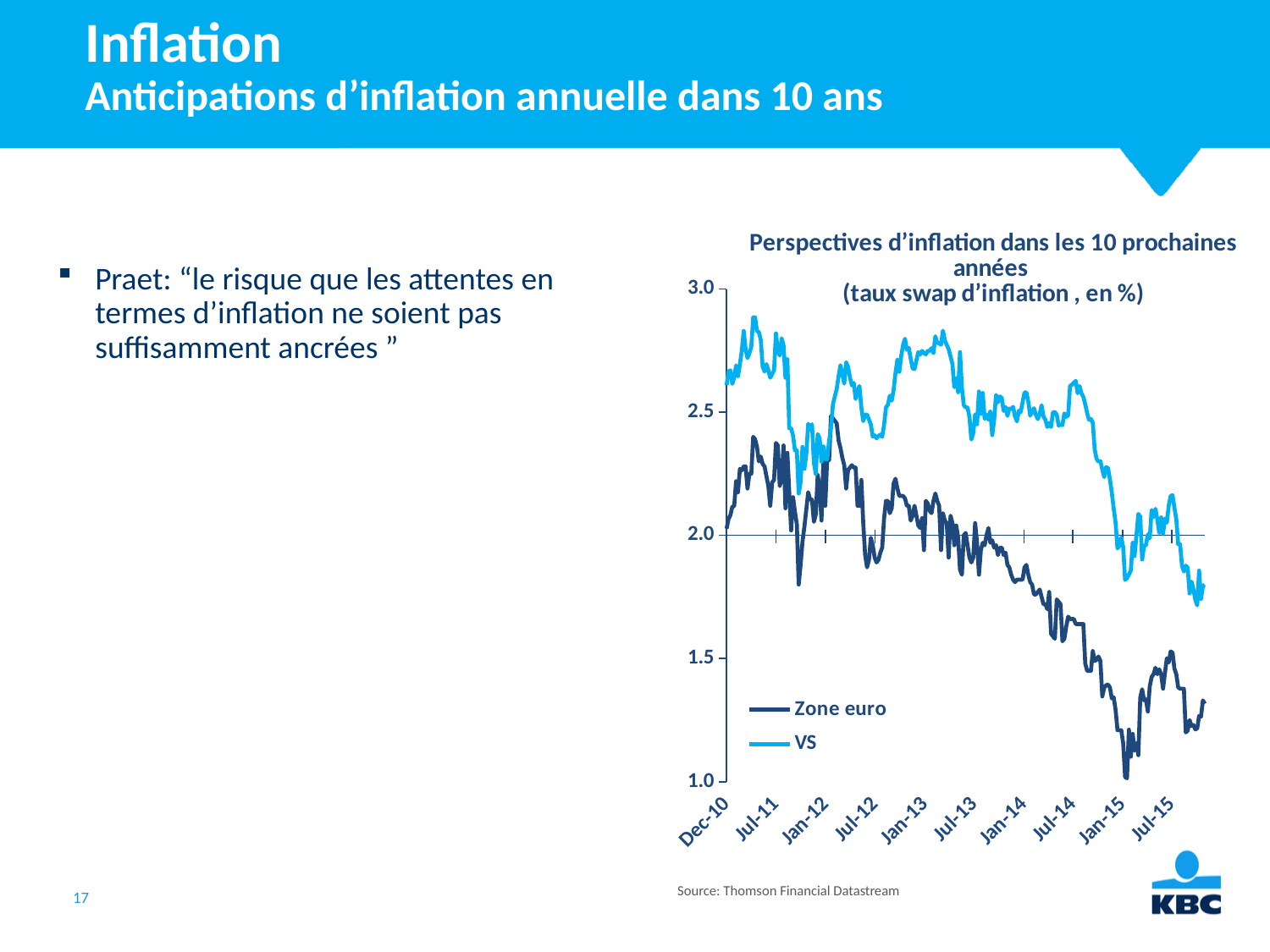
What is the title of the chart? Perspectives d'inflation dans les 10 prochaines années (taux swap d'inflation, en %) What kind of chart is shown on the slide? Line chart Does the VS series rise or fall overall from Dec-10 to Jul-15? Fall At Jan-14, which series has the higher value, Zone euro or VS? VS Is the value for VS at Jan-13 greater or less than 2.5? greater What are the two series named in the chart's legend? Zone euro and VS How many date labels are shown on the x axis of the chart? 10 Is the value for Zone euro at Jan-15 greater or less than 1.5? less Is the value for Zone euro at Jan-12 greater or less than 2.0? greater Does the Zone euro series rise or fall overall from Dec-10 to Jul-15? Fall How many series does the chart's legend list? 2